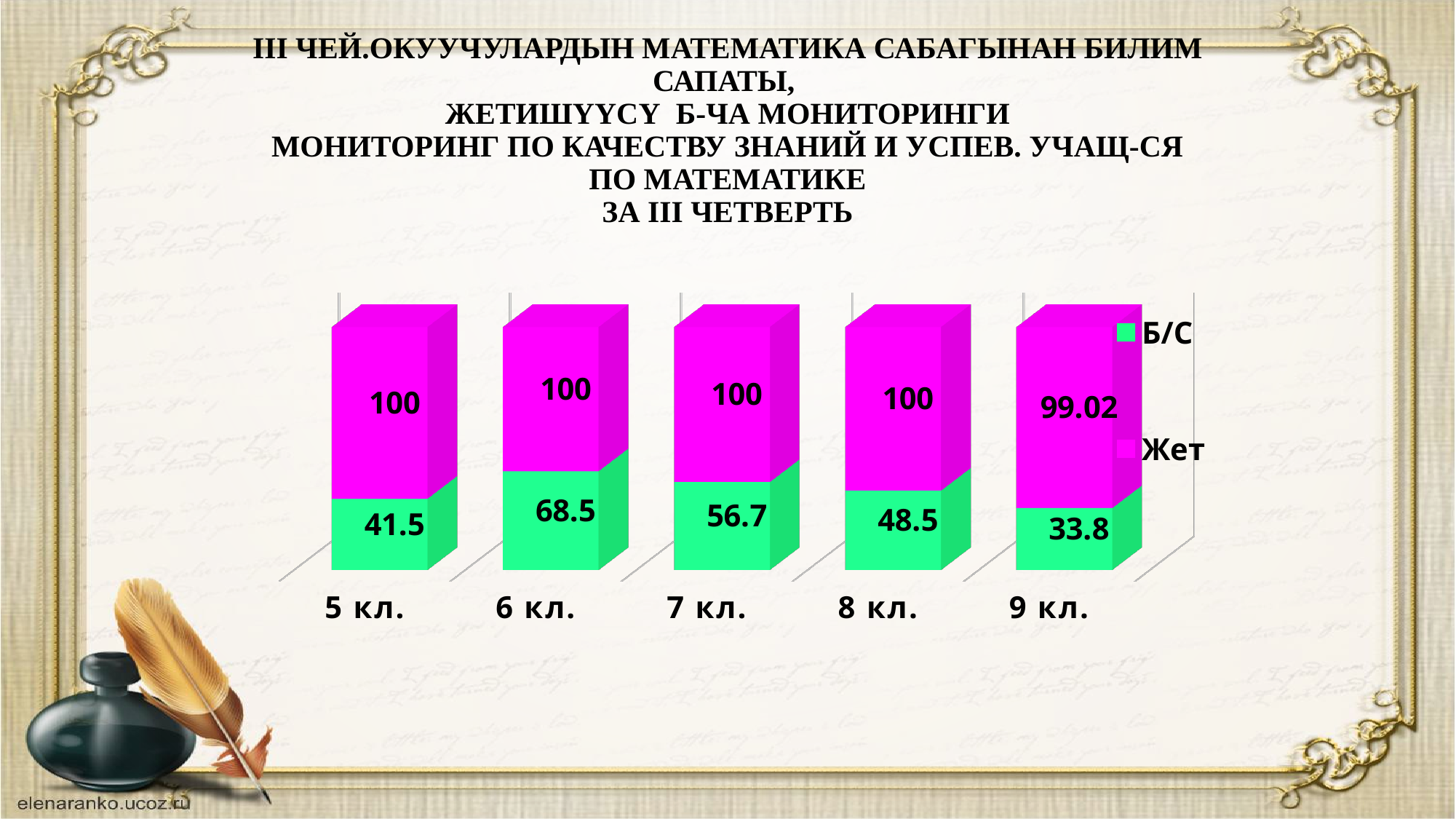
What is the difference between the Б/С values for 6 кл. and 5 кл.? 27 How many classes are shown on the x axis? 5 Which series is shown in green? Б/С Which class has the highest Б/С value? 6 кл. Which is larger, the Б/С value for 7 кл. or for 8 кл.? 7 кл. What kind of chart is shown on the slide? Stacked bar chart What is the Б/С value for 6 кл.? 68.5 Which class has the lowest Б/С value? 9 кл. How many series does the legend list? 2 What is the Жет value for 9 кл.? 99.02 What is the Б/С value for 9 кл.? 33.8 What is the total of the stacked bar for 5 кл.? 141.5